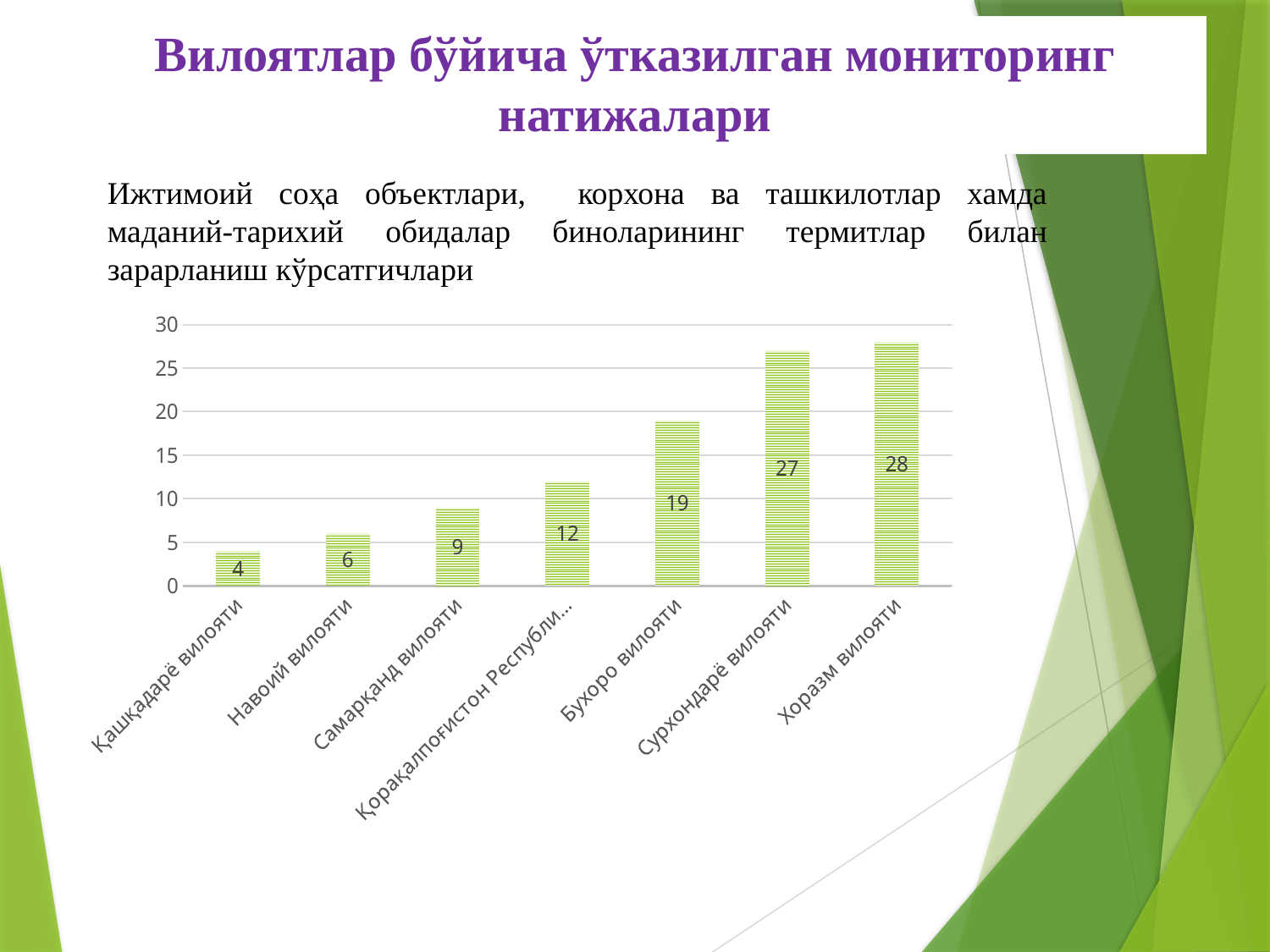
What type of chart is shown on the slide? bar chart What is the difference between the values for Хоразм вилояти and Сурхондарё вилояти? 1 Which region has the lowest value in the chart? Қашқадарё вилояти Which is larger, the value for Бухоро вилояти or the value for Самарқанд вилояти? Бухоро вилояти What is the value for Сурхондарё вилояти? 27 What is the value for Бухоро вилояти? 19 Do the values rise or fall moving from left to right along the x axis? rise Which region has the highest value in the chart? Хоразм вилояти What is the value for Навоий вилояти? 6 What is the value for Қашқадарё вилояти? 4 How many regions (categories) are shown in the chart? 7 What is the value for Самарқанд вилояти? 9